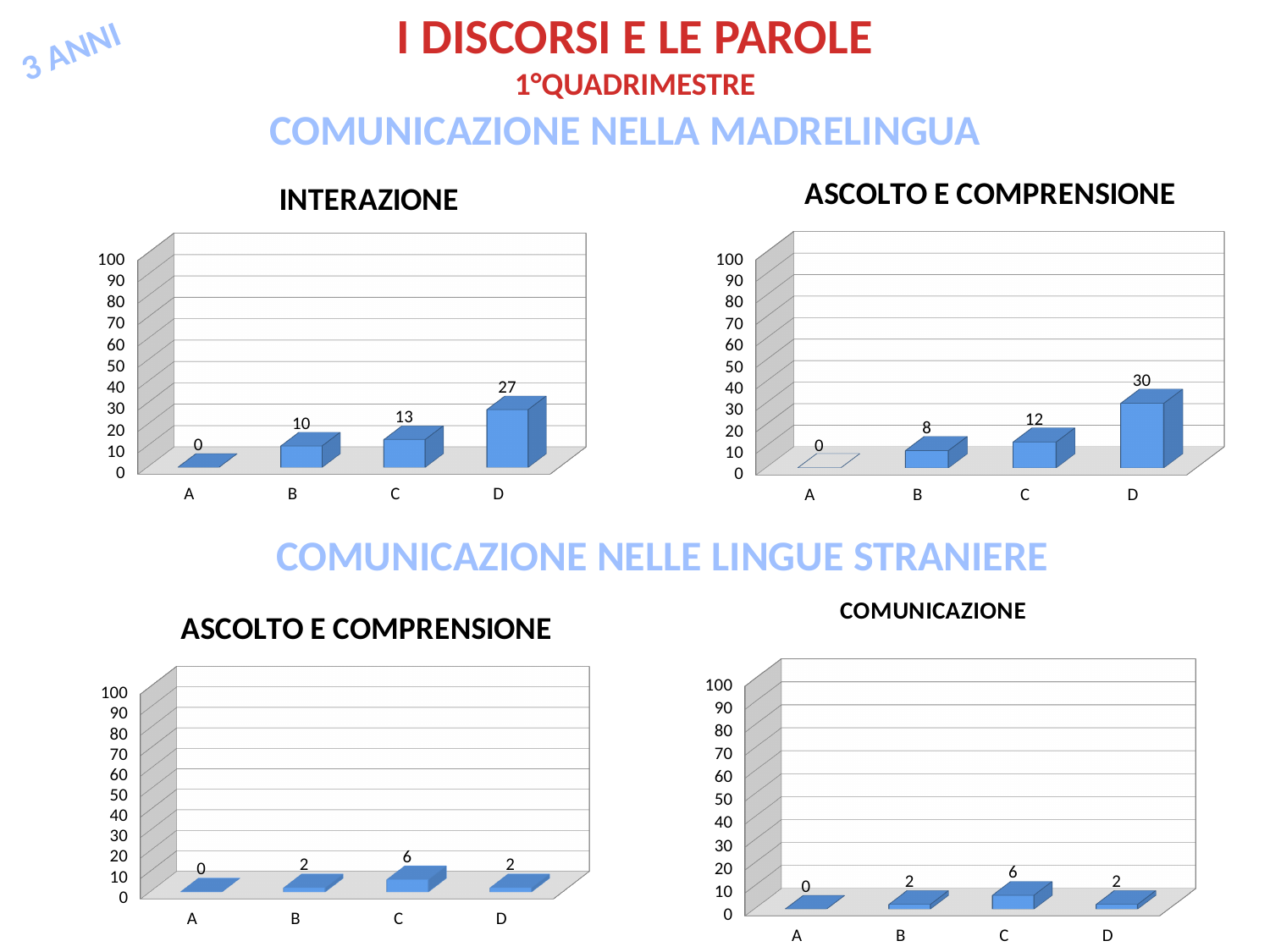
In the ASCOLTO E COMPRENSIONE chart under COMUNICAZIONE NELLE LINGUE STRANIERE (bottom left), which category has the highest value? C In the COMUNICAZIONE chart (bottom right), what is the value for category D? 2 In the INTERAZIONE chart, what is the value for category D? 27 What kind of chart is the INTERAZIONE chart? Bar chart In the ASCOLTO E COMPRENSIONE chart under COMUNICAZIONE NELLA MADRELINGUA (top right), what is the value for category D? 30 In the ASCOLTO E COMPRENSIONE chart under COMUNICAZIONE NELLE LINGUE STRANIERE (bottom left), what is the value for category C? 6 In the ASCOLTO E COMPRENSIONE chart under COMUNICAZIONE NELLA MADRELINGUA (top right), what is the value for category B? 8 In the COMUNICAZIONE chart (bottom right), how many categories are shown on the x axis? 4 In the INTERAZIONE chart, which category has the highest value? D In the INTERAZIONE chart, what is the difference between the values for D and C? 14 In the INTERAZIONE chart, what is the value for category B? 10 In the ASCOLTO E COMPRENSIONE chart under COMUNICAZIONE NELLA MADRELINGUA (top right), which category has the lowest value? A